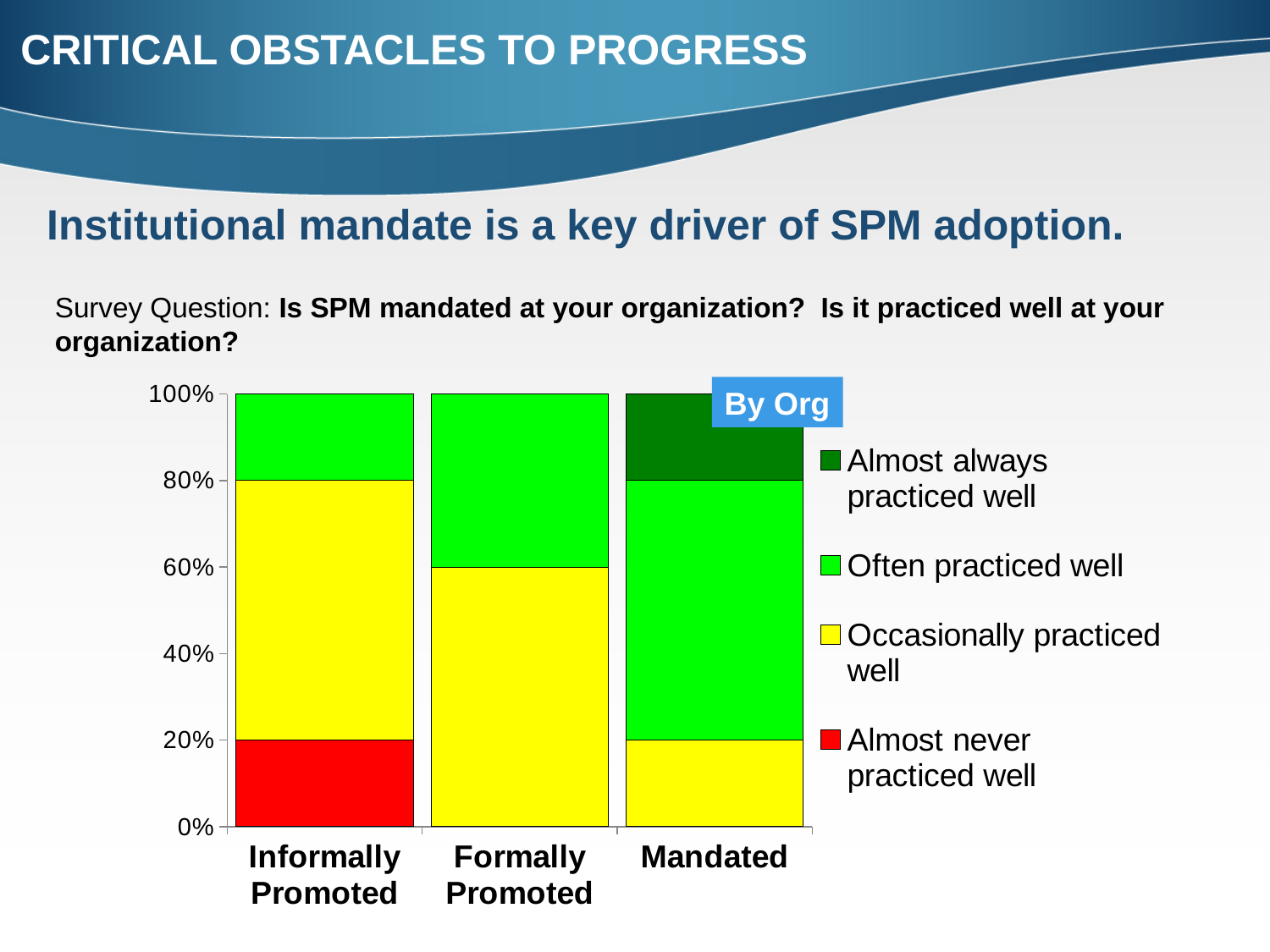
Which category on the x axis is the only one with an 'Almost never practiced well' segment? Informally Promoted What kind of chart is shown on the slide? stacked bar chart How many categories are shown on the x axis of the chart? 3 What is the share of 'Almost never practiced well' for Informally Promoted? 20% What is the share of 'Occasionally practiced well' for Formally Promoted? 60% Which category has the largest 'Often practiced well' share? Mandated Which category on the x axis is the only one with an 'Almost always practiced well' segment? Mandated Is the 'Often practiced well' share for Informally Promoted greater or less than 40%? less How many series does the chart's legend list? 4 Is the 'Often practiced well' share for Mandated greater or less than 40%? greater What is the share of 'Occasionally practiced well' for Mandated? 20% Which category has the larger 'Occasionally practiced well' share, Informally Promoted or Mandated? Informally Promoted